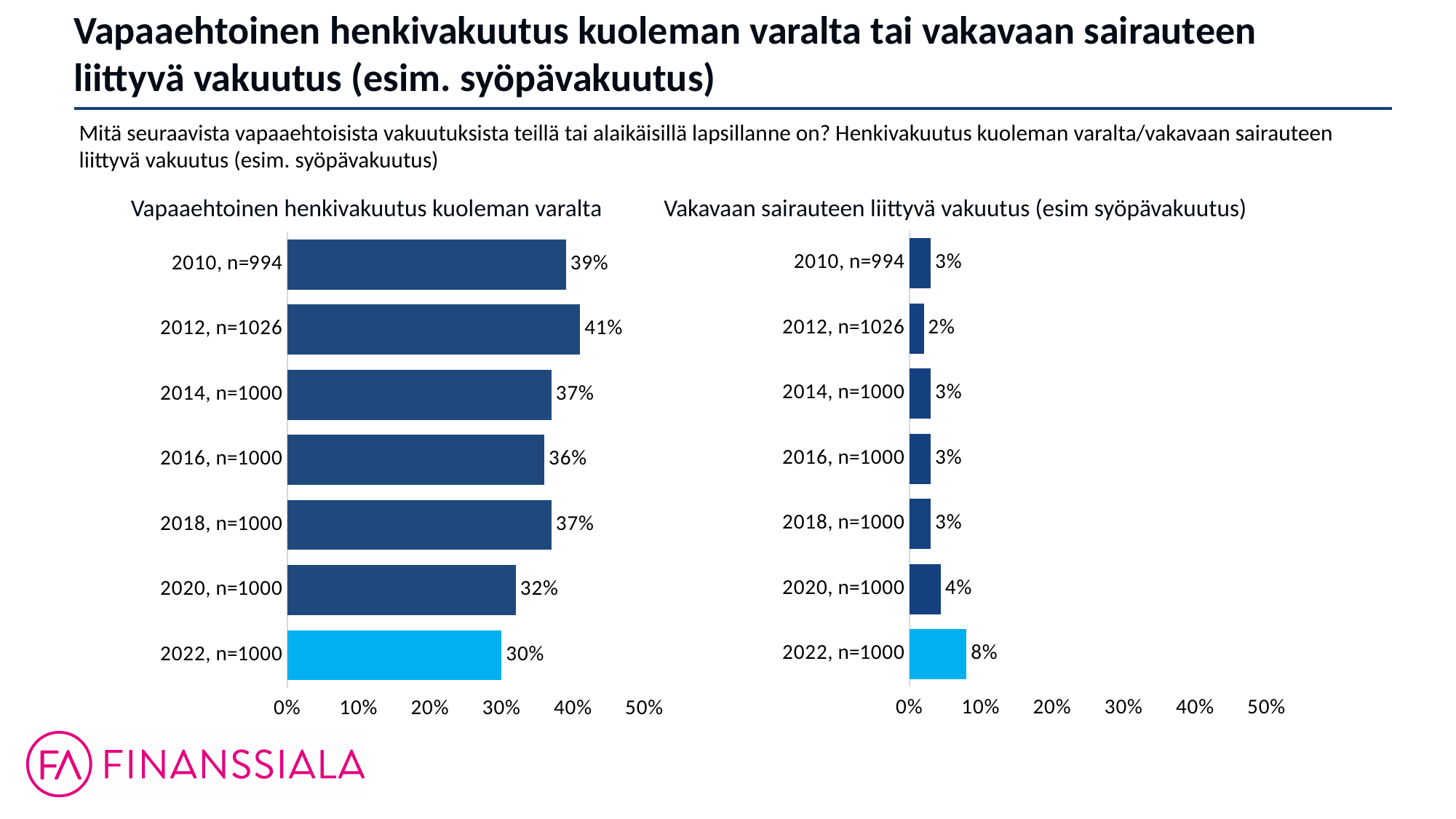
What type of chart is the left chart 'Vapaaehtoinen henkivakuutus kuoleman varalta'? bar chart In the right chart 'Vakavaan sairauteen liittyvä vakuutus (esim syöpävakuutus)', which category has the highest value? 2022, n=1000 In the left chart 'Vapaaehtoinen henkivakuutus kuoleman varalta', do the values generally rise or fall from 2012 to 2022? fall In the left chart 'Vapaaehtoinen henkivakuutus kuoleman varalta', what is the value for 2022, n=1000? 30% In the left chart 'Vapaaehtoinen henkivakuutus kuoleman varalta', which category has the lowest value? 2022, n=1000 In the left chart 'Vapaaehtoinen henkivakuutus kuoleman varalta', what is the difference between the values for 2012, n=1026 and 2022, n=1000? 11% In the right chart 'Vakavaan sairauteen liittyvä vakuutus (esim syöpävakuutus)', what is the difference between the values for 2022, n=1000 and 2020, n=1000? 4% In the right chart 'Vakavaan sairauteen liittyvä vakuutus (esim syöpävakuutus)', which category has the lowest value? 2012, n=1026 In the left chart 'Vapaaehtoinen henkivakuutus kuoleman varalta', is the value for 2010, n=994 greater or less than 30%? greater In the right chart 'Vakavaan sairauteen liittyvä vakuutus (esim syöpävakuutus)', what is the value for 2022, n=1000? 8% How many categories does the right chart 'Vakavaan sairauteen liittyvä vakuutus (esim syöpävakuutus)' show? 7 In the left chart 'Vapaaehtoinen henkivakuutus kuoleman varalta', which category has the highest value? 2012, n=1026